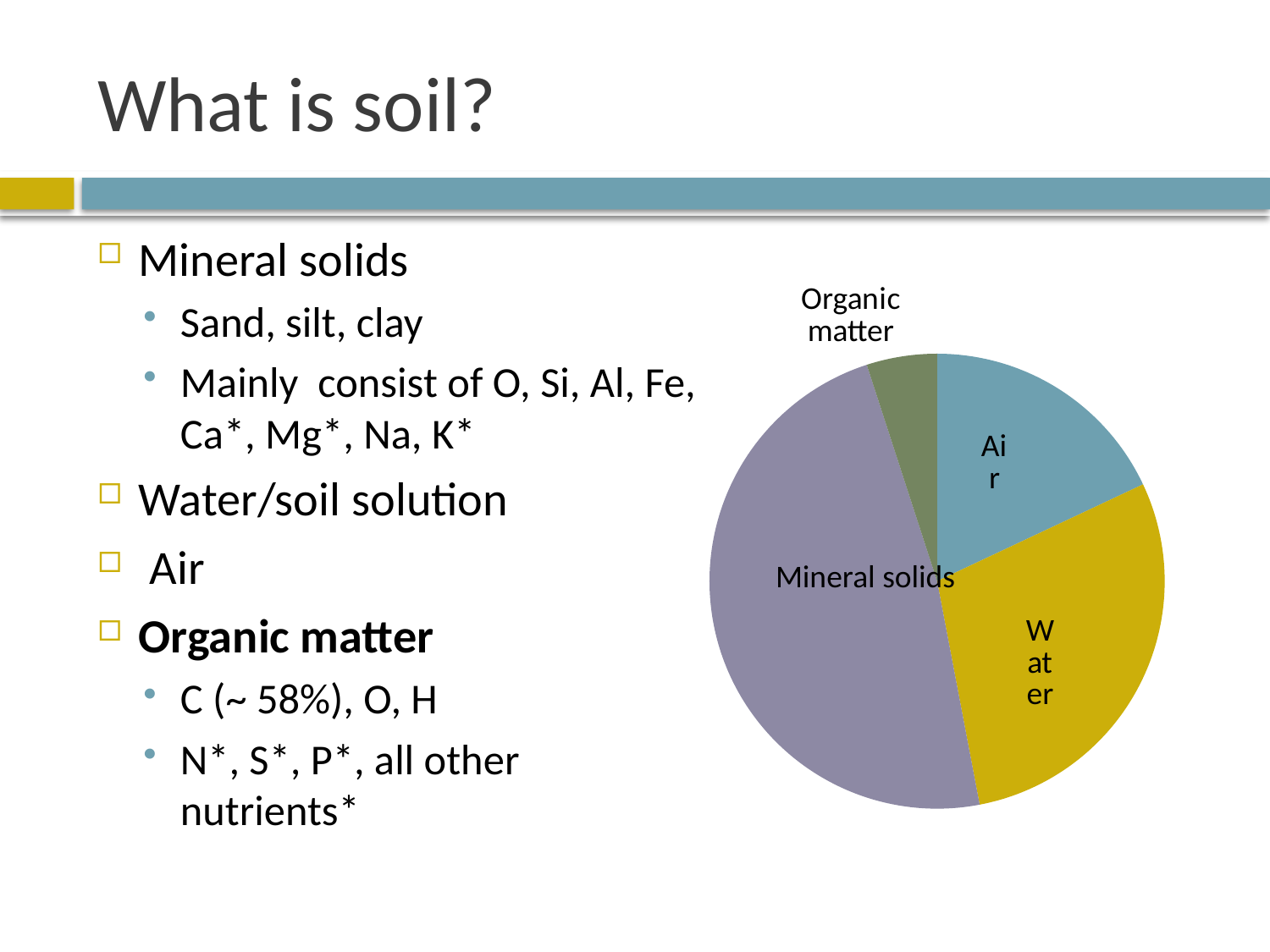
Which slice is larger in the pie chart, Water or Organic matter? Water Which slice of the pie chart is the largest? Mineral solids Which slice is larger in the pie chart, Mineral solids or Water? Mineral solids Which slice is larger in the pie chart, Water or Air? Water Which slice of the pie chart is the smallest? Organic matter What kind of chart is shown on the slide? pie chart How many slices does the pie chart have? 4 What colour is the Mineral solids slice in the pie chart? purple What colour is the Water slice in the pie chart? yellow